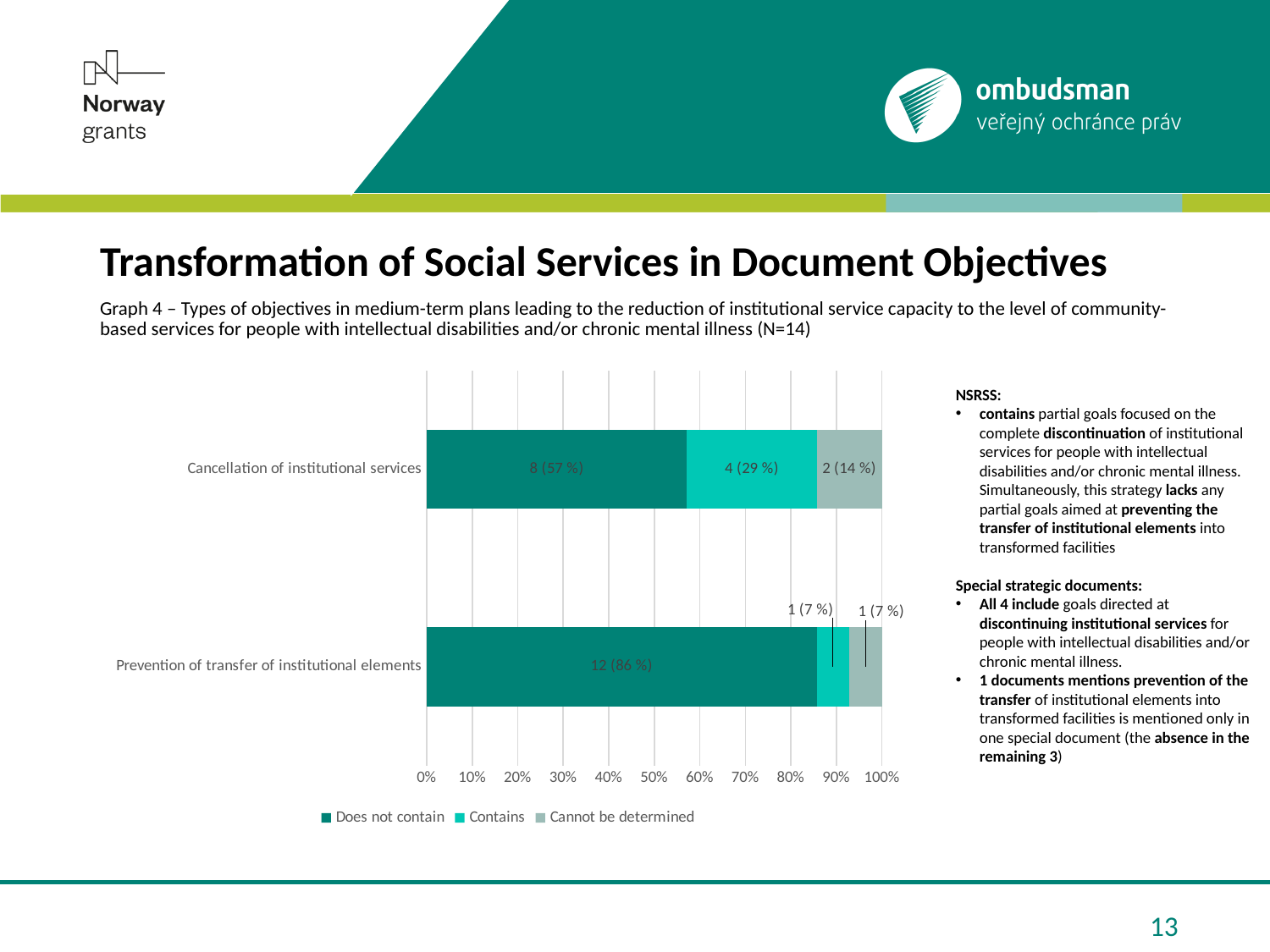
What is the value for "Does not contain" in the "Prevention of transfer of institutional elements" category? 12 (86 %) Is the "Contains" value larger for "Cancellation of institutional services" or for "Prevention of transfer of institutional elements"? Cancellation of institutional services Which category has the higher "Does not contain" value? Prevention of transfer of institutional elements What is the total number of documents in the "Cancellation of institutional services" bar? 14 What is the value for "Does not contain" in the "Cancellation of institutional services" category? 8 (57 %) How many series does the legend list? 3 Which category has the lower "Contains" value? Prevention of transfer of institutional elements What is the value for "Cannot be determined" in the "Cancellation of institutional services" category? 2 (14 %) What kind of chart is shown on the slide? Stacked bar chart How many categories are shown on the y axis of the chart? 2 What is the value for "Contains" in the "Prevention of transfer of institutional elements" category? 1 (7 %) What is the difference in document count for "Does not contain" between "Prevention of transfer of institutional elements" and "Cancellation of institutional services"? 4